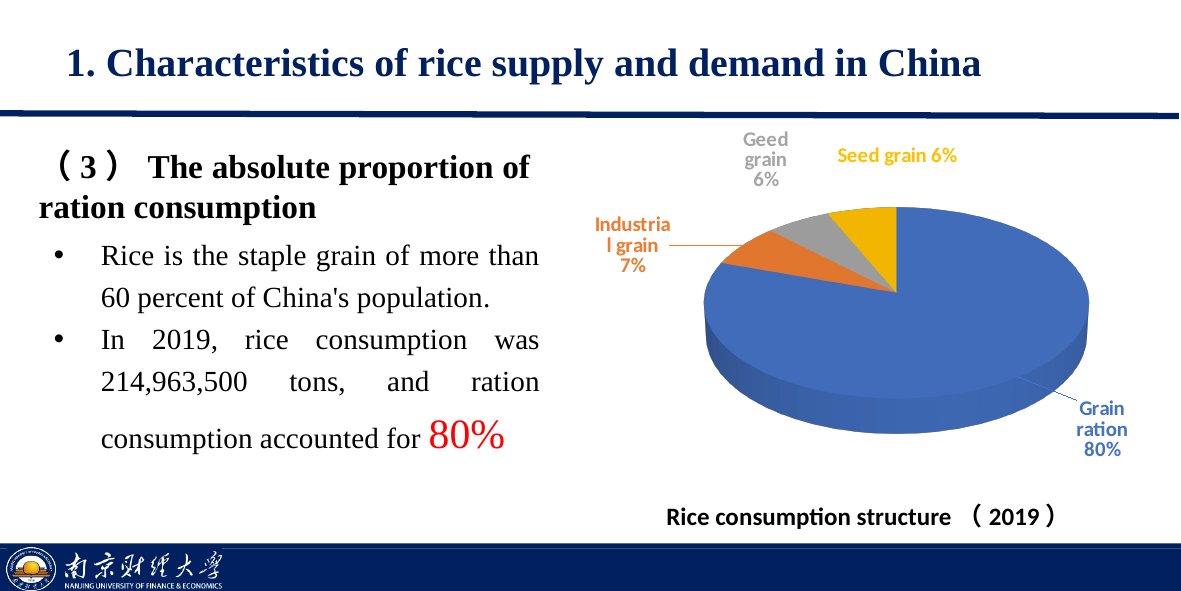
What is the title of the pie chart? Rice consumption structure (2019) How many slices does the pie chart have? 4 What type of chart is shown on the slide? pie chart What share of rice consumption does Industrial grain account for in the pie chart? 7% What colour is the Grain ration slice in the pie chart? blue What is the difference in percentage points between Grain ration and Industrial grain? 73 What share of rice consumption does Grain ration account for in the pie chart? 80% Which is larger, the share for Industrial grain or the share for Seed grain? Industrial grain What is the combined share of Industrial grain and Seed grain in the pie chart? 13% What share of rice consumption does Seed grain account for in the pie chart? 6% Which category has the largest slice in the pie chart? Grain ration